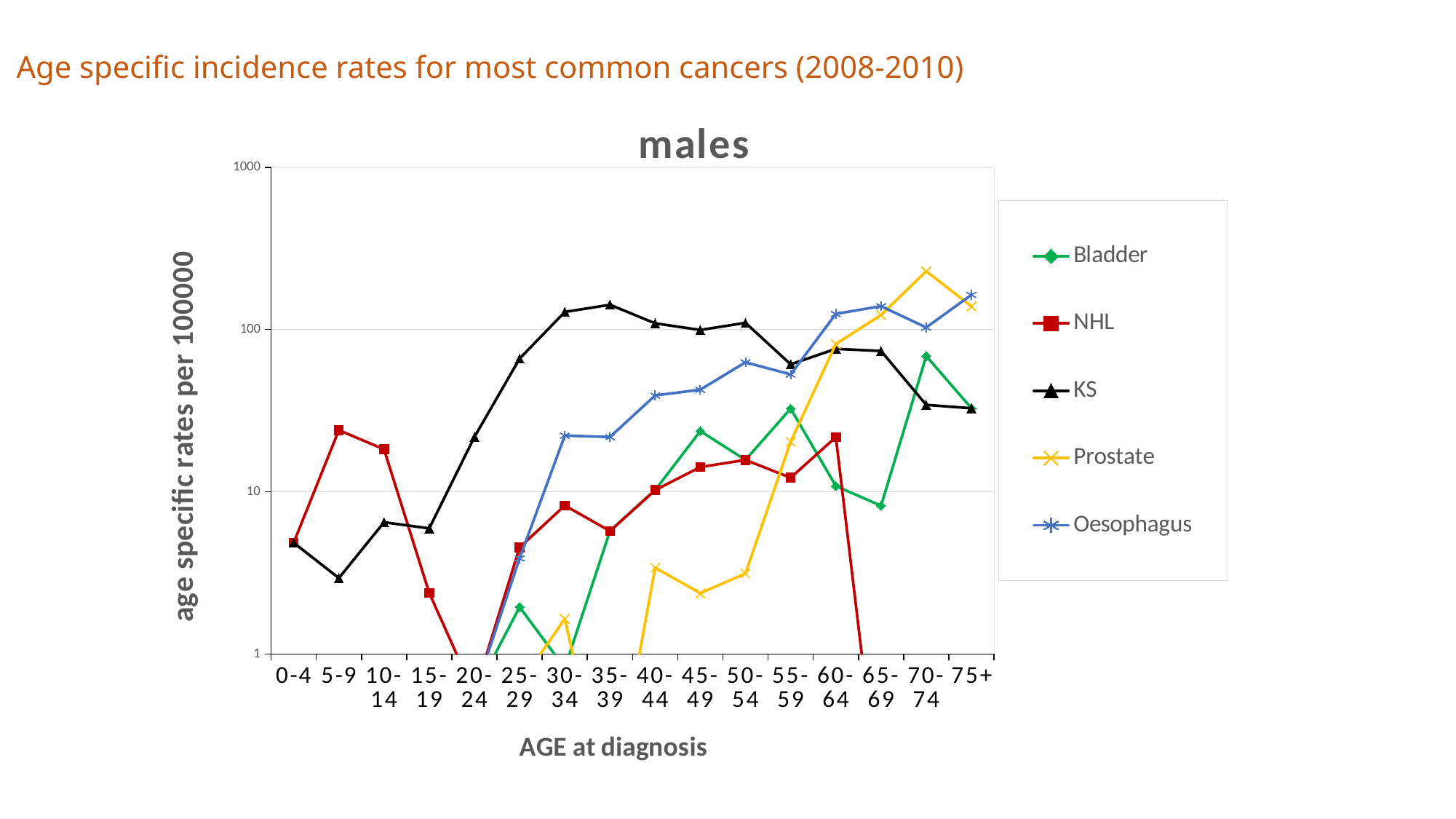
What kind of chart is shown on the slide? line chart How many series does the legend list? 5 Is the value for NHL at age 5-9 greater or less than 10? greater Is the value for Prostate at age 70-74 greater or less than 100? greater Is the value for KS at age 30-34 greater or less than 100? greater What is the label on the y axis of the chart? age specific rates per 100000 At age 75+, which is larger, the value for Oesophagus or the value for KS? Oesophagus Which series has the highest value at age 70-74? Prostate Which series has the highest value at age 30-34? KS Does the Prostate line rise or fall from age 55-59 to age 70-74? rise How many age groups are shown along the x axis? 16